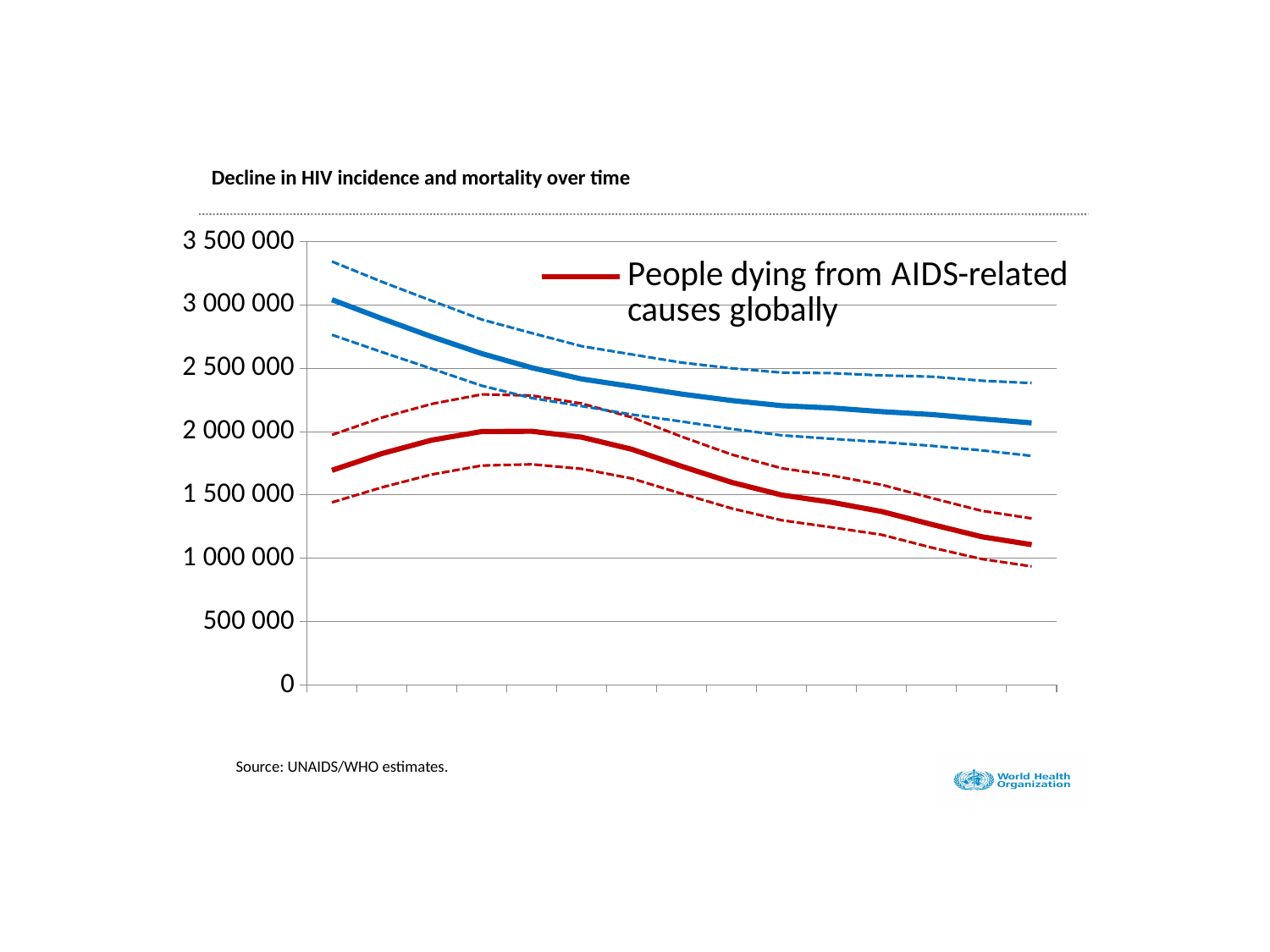
Is the final value of the solid line for People dying from AIDS-related causes globally greater or less than 1 500 000? less How many series does the chart legend list? 1 What is the title of the chart? Decline in HIV incidence and mortality over time Which series is named in the chart legend? People dying from AIDS-related causes globally Does the solid line for People dying from AIDS-related causes globally end higher or lower than it starts? Lower Is the peak of the solid line for People dying from AIDS-related causes globally greater or less than 2 500 000? less What is the highest value shown on the vertical axis? 3 500 000 At the left end of the chart, which solid line is higher: the blue line or the red line for People dying from AIDS-related causes globally? The blue line Is the starting value of the solid line for People dying from AIDS-related causes globally greater or less than 1 500 000? greater Does the solid blue line rise or fall from left to right? Fall What kind of chart is shown on the slide? Line chart